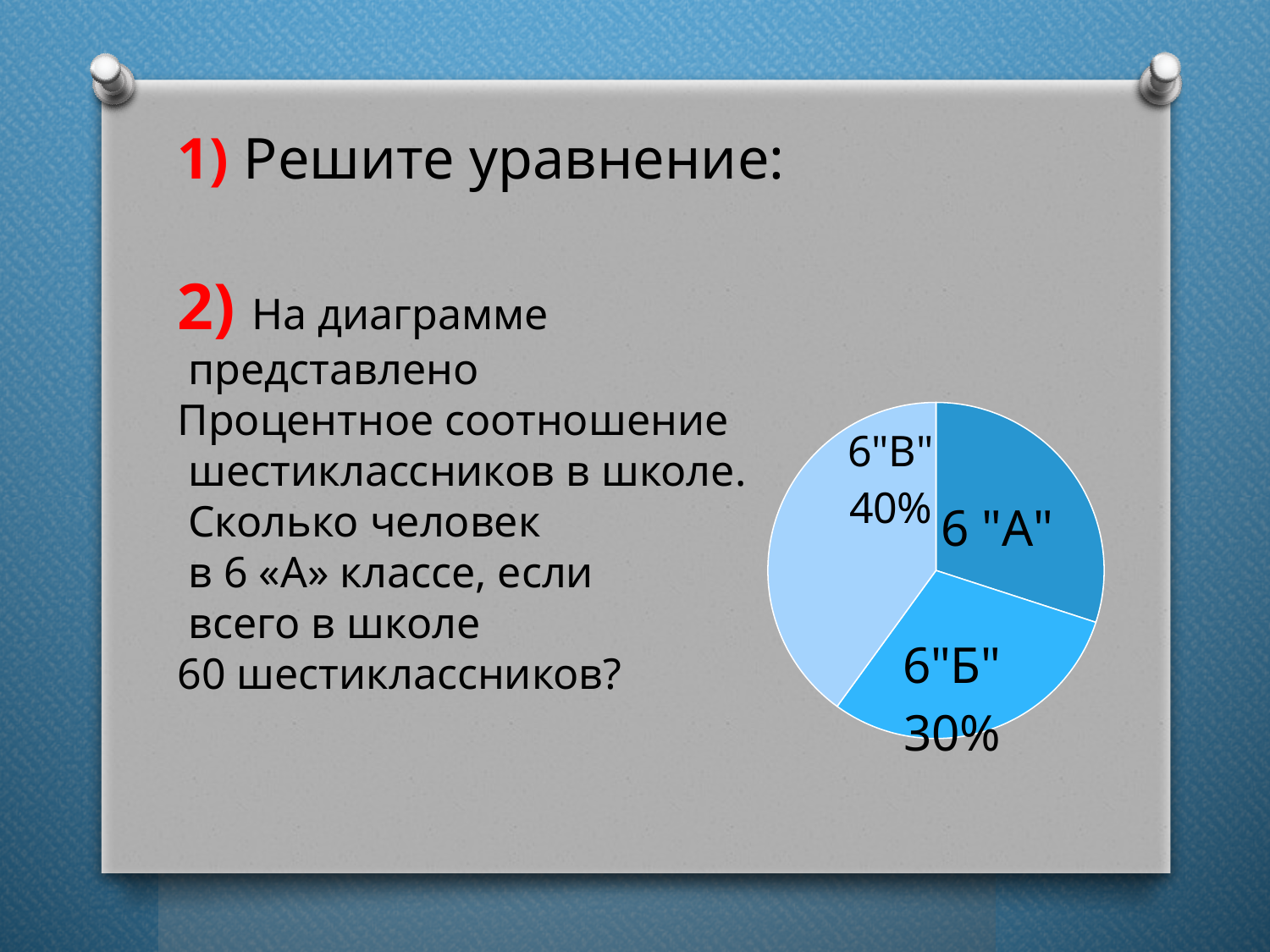
What percentage is shown for the 6"Б" slice? 30% Which slice of the pie is the darkest shade of blue? 6 "А" Which slice is larger, 6"В" or 6"Б"? 6"В" Which slice of the pie is the lightest shade of blue? 6"В" How many slices does the pie chart have? 3 What share of the pie does 6"В" take? 40% What share of the pie does 6"Б" take? 30% What is the difference in percentage points between the 6"В" slice and the 6"Б" slice? 10% Which class has the largest slice of the pie? 6"В" What type of chart is shown on the slide? pie chart What percentage is shown for the 6"В" slice? 40%